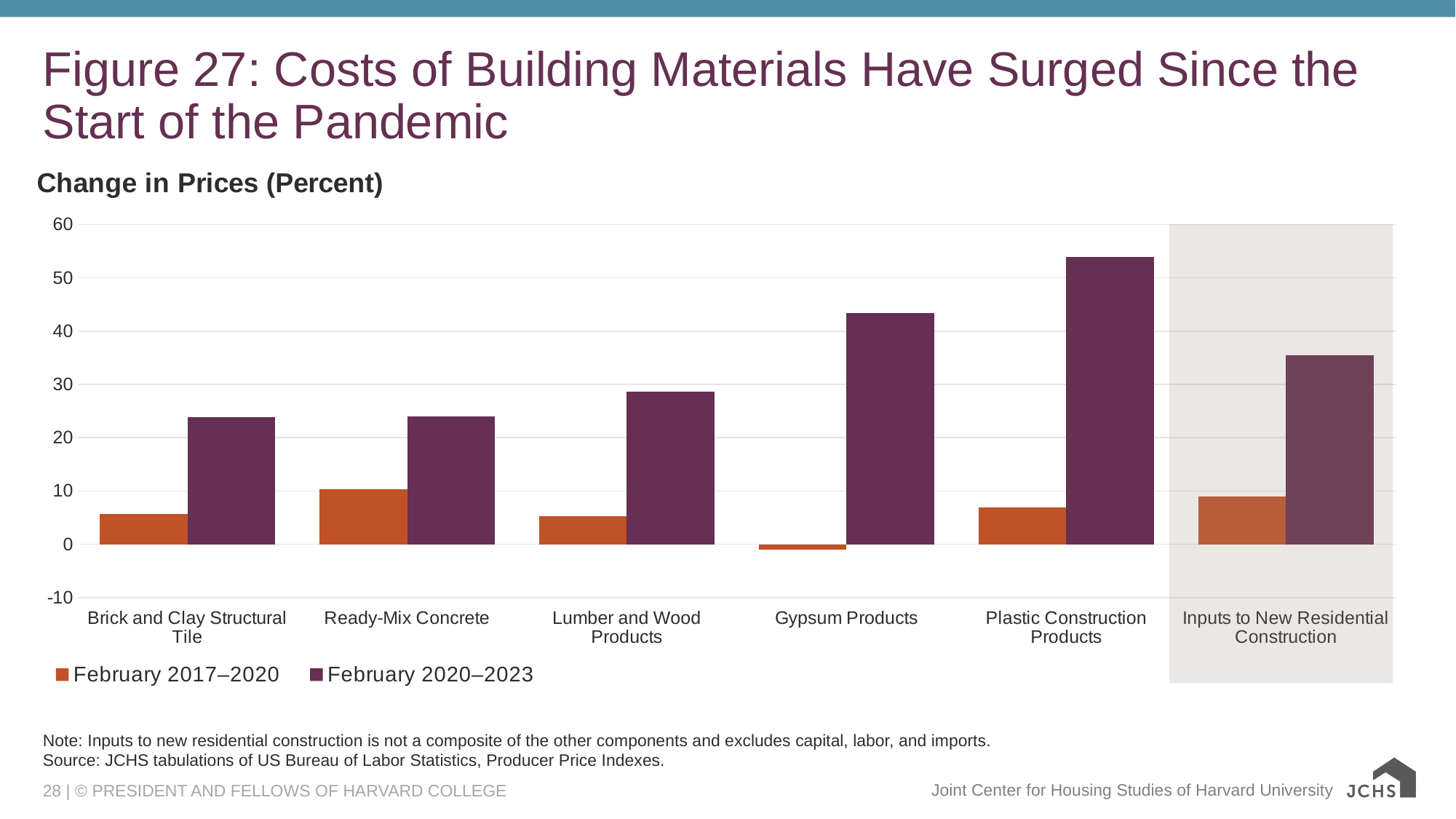
Is the February 2017–2020 value for Gypsum Products greater or less than 0? less Is the February 2020–2023 value for Gypsum Products greater or less than 40? greater What are the two series named in the legend? February 2017–2020 and February 2020–2023 Is the February 2020–2023 value for Lumber and Wood Products greater or less than 30? less Which category has the highest value for February 2020–2023? Plastic Construction Products How many series does the legend list? 2 Which is larger: the February 2020–2023 value for Gypsum Products or for Lumber and Wood Products? Gypsum Products How many material categories are shown on the x axis? 6 Which is larger: the February 2020–2023 value for Plastic Construction Products or for Inputs to New Residential Construction? Plastic Construction Products What kind of chart is shown on the slide? Bar chart Which category has the lowest value for February 2017–2020? Gypsum Products